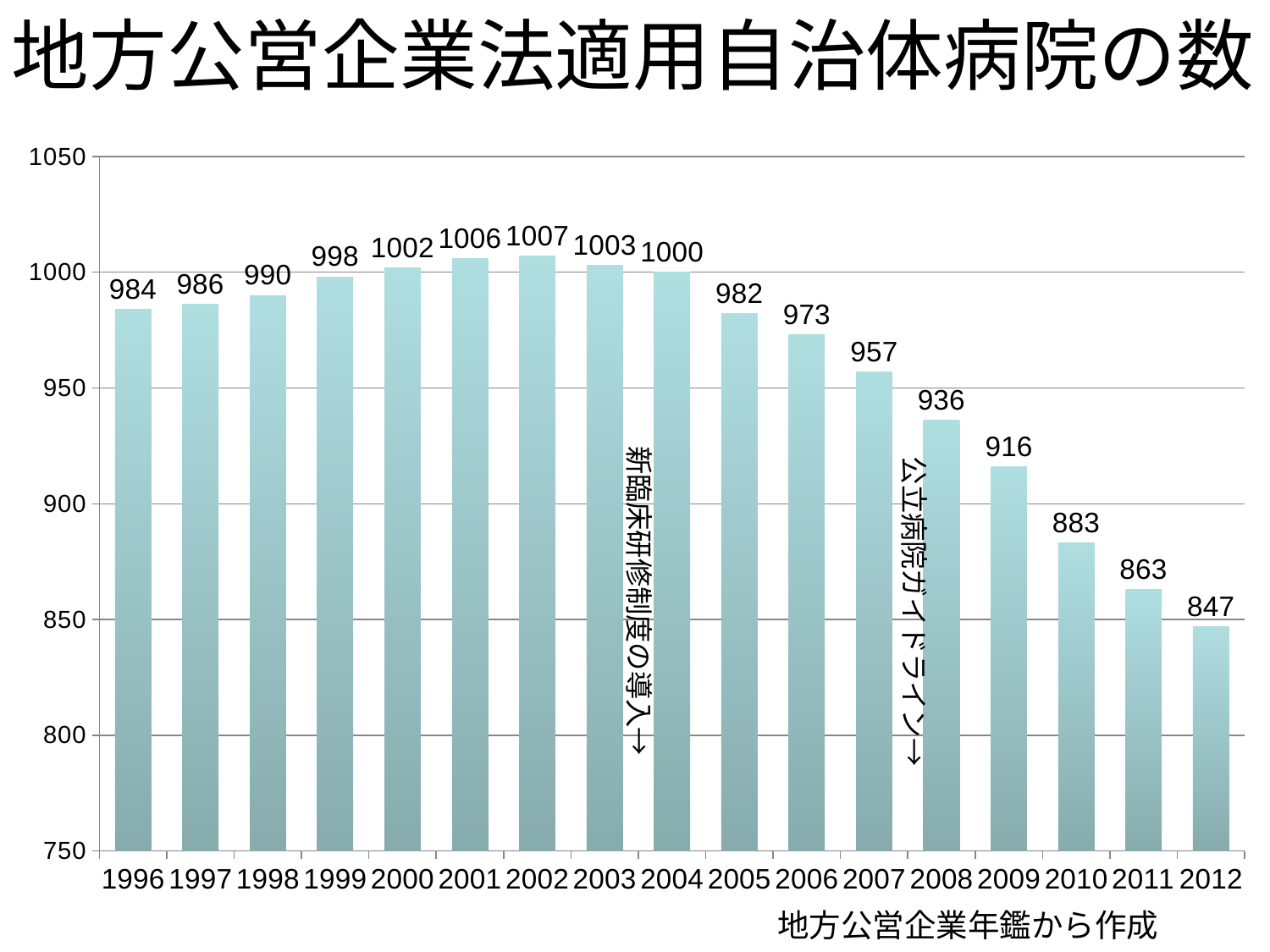
What is the difference between the values for 2002 and 2012? 160 Do the values rise or fall from 2004 to 2012? fall What is the title of the chart? 地方公営企業法適用自治体病院の数 What is the value for 2002? 1007 Which year has the highest value? 2002 Which year has the lowest value? 2012 What is the value for 2012? 847 How many years are shown on the x axis? 17 Is the value for 2009 greater or less than 900? greater What kind of chart is this? bar chart Which is larger, the value for 2005 or the value for 2008? 2005 What is the value for 1996? 984